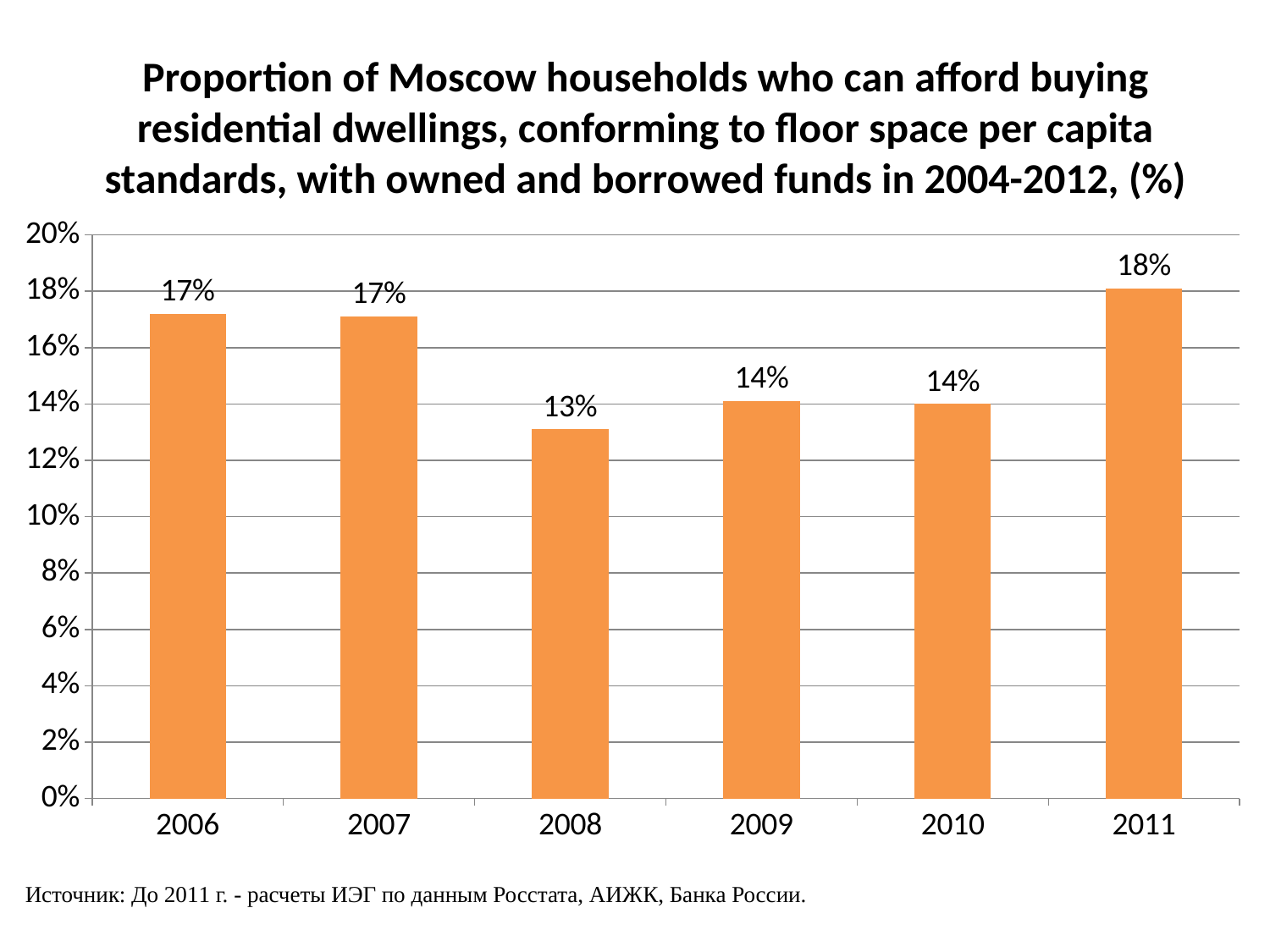
Is the value for 2011 greater or less than 16%? greater How many years are shown on the x axis? 6 Which year has the highest value? 2011 Which year has the lowest value? 2008 What kind of chart is shown on the slide? bar chart What is the value for 2009? 14% Is the value for 2008 greater or less than 14%? less From 2008 to 2011, do the values rise or fall? rise What is the value for 2008? 13% What is the value for 2011? 18% What is the difference between the values for 2011 and 2008? 5% Which is larger, the value for 2011 or the value for 2010? 2011